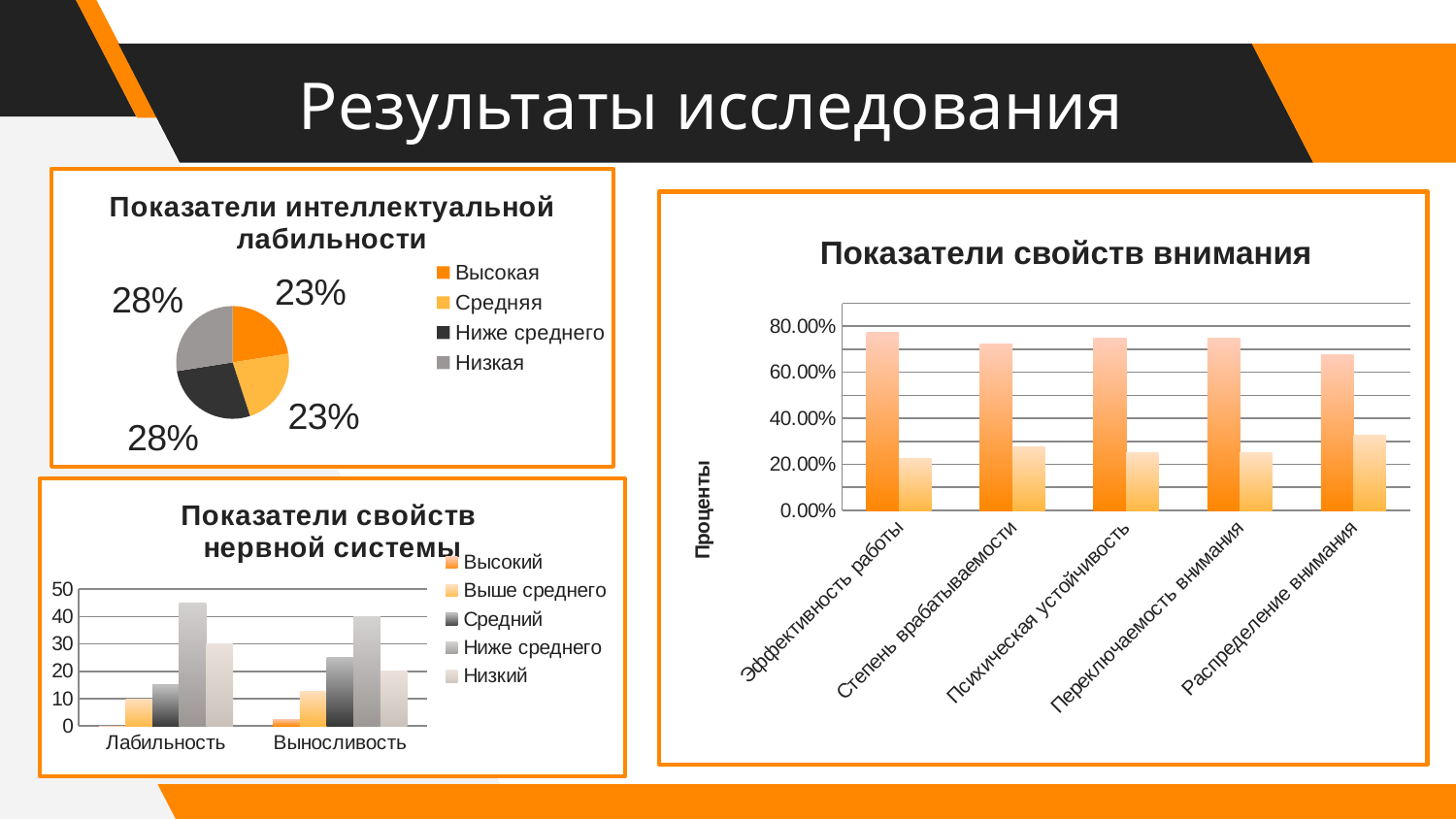
How many entries does the legend of the chart 'Показатели интеллектуальной лабильности' list? 4 In the chart 'Показатели свойств нервной системы', is the value of 'Низкий' for 'Лабильность' greater or less than 20? greater What is the y-axis title of the chart 'Показатели свойств внимания'? Проценты In the pie chart 'Показатели интеллектуальной лабильности', what share does 'Низкая' have? 28% How many series does the legend of the chart 'Показатели свойств нервной системы' list? 5 How many categories are shown on the x axis of the chart 'Показатели свойств нервной системы'? 2 In the chart 'Показатели свойств нервной системы', is the value of 'Средний' larger for 'Лабильность' or for 'Выносливость'? Выносливость How many categories are shown on the x axis of the chart 'Показатели свойств внимания'? 5 In the chart 'Показатели свойств нервной системы', which series has the highest value for 'Лабильность'? Ниже среднего What kind of chart is 'Показатели интеллектуальной лабильности'? pie chart In the chart 'Показатели свойств внимания', is the taller bar for 'Распределение внимания' greater or less than 60.00%? greater In the pie chart 'Показатели интеллектуальной лабильности', what share does 'Высокая' have? 23%